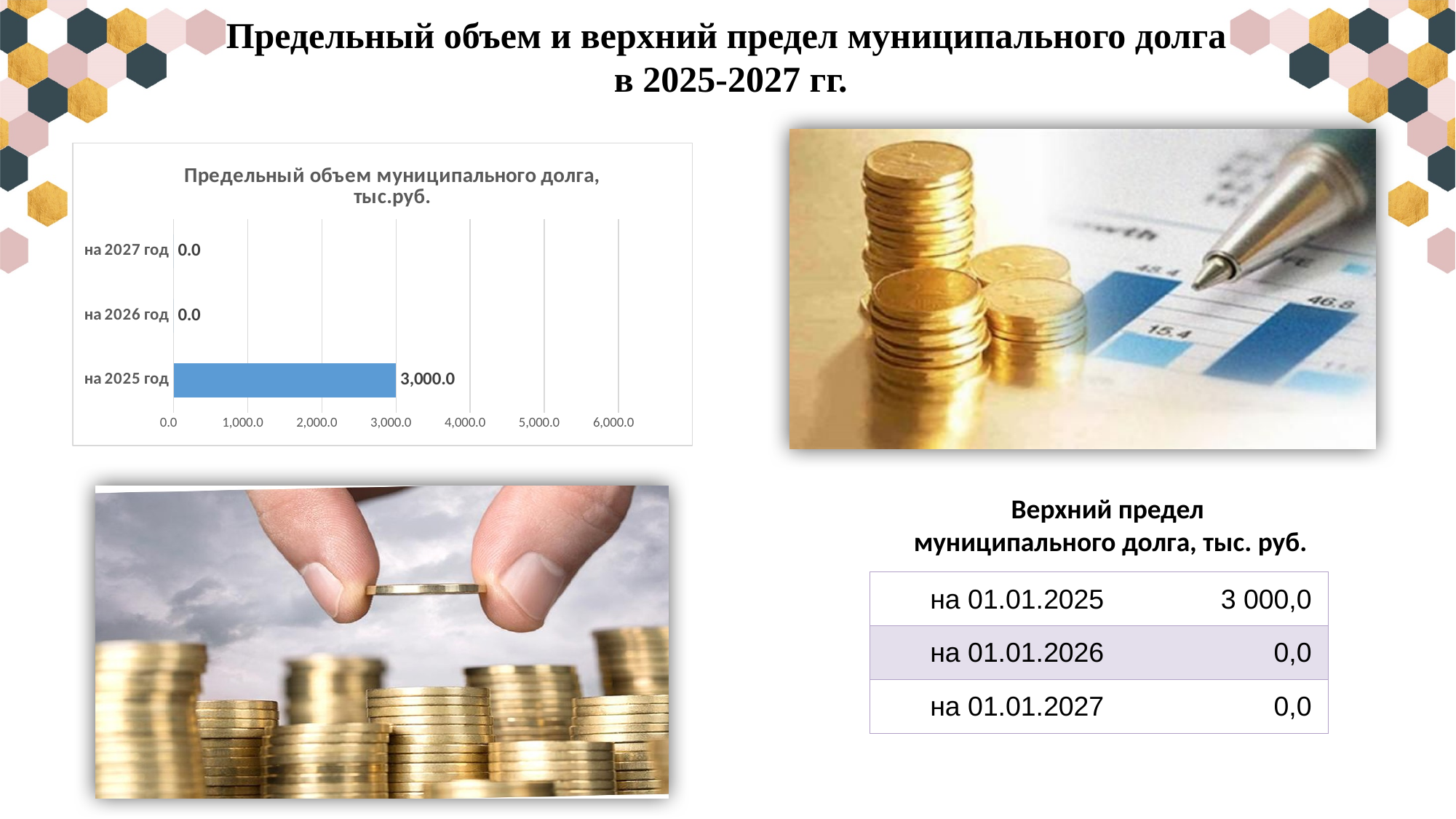
What is the difference between the values for "на 2025 год" and "на 2026 год"? 3,000.0 What is the value for "на 2027 год" in the chart? 0.0 What is the value for "на 2026 год" in the chart? 0.0 What kind of chart is shown on the slide? bar chart Which year has the highest value in the chart? на 2025 год Do the values rise or fall from 2025 to 2027? fall Which is larger, the value for "на 2025 год" or the value for "на 2027 год"? на 2025 год How many categories (years) are shown in the chart? 3 What is the highest value shown on the chart's horizontal axis? 6,000.0 Is the value for "на 2025 год" greater or less than 2,000.0? greater What is the title of the chart? Предельный объем муниципального долга, тыс.руб. What is the value for "на 2025 год" in the chart? 3,000.0